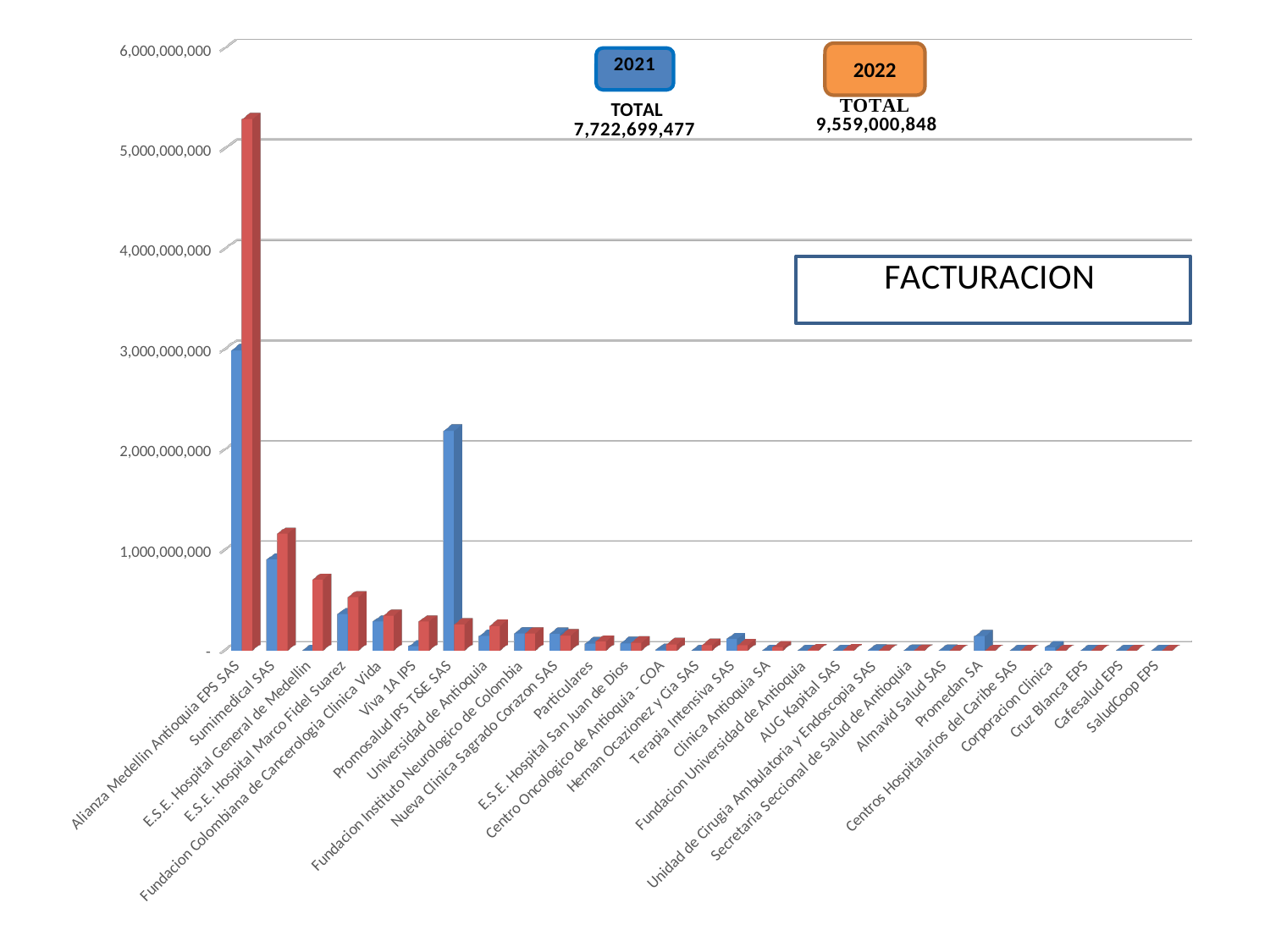
Is the 2021 value for Promosalud IPS T&E SAS greater or less than 2,000,000,000? greater Which category has the highest 2021 value? Alianza Medellin Antioquia EPS SAS What kind of chart is shown on the slide? Bar chart For Promosalud IPS T&E SAS, which year has the larger value, 2021 or 2022? 2021 What is the title shown in the box on the chart? FACTURACION What is the printed TOTAL for 2022? 9,559,000,848 What is the difference between the 2022 total and the 2021 total? 1,836,301,371 Which category has the highest 2022 value? Alianza Medellin Antioquia EPS SAS Is the 2022 value for Alianza Medellin Antioquia EPS SAS greater or less than 5,000,000,000? greater What is the printed TOTAL for 2021? 7,722,699,477 Which year has the larger printed total, 2021 or 2022? 2022